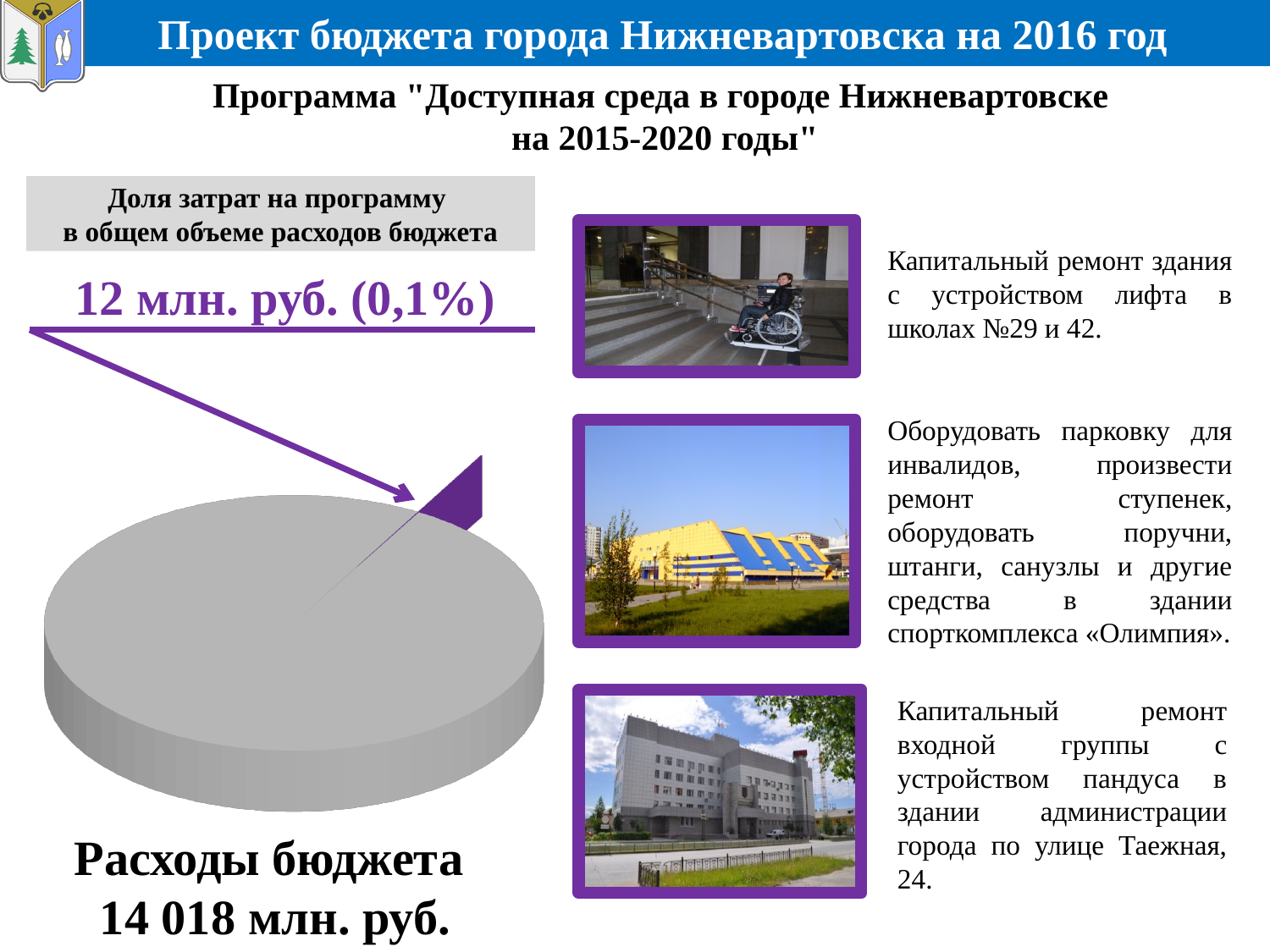
What kind of chart is shown on the slide? pie chart What share of total budget expenditure does the program slice represent in the pie chart? 0,1% Is the program expenditure share in the pie chart greater or less than 1%? less How many slices does the pie chart have? 2 What colour is the slice representing the program expenditure in the pie chart? purple Which slice of the pie chart is larger: the program expenditure slice or the rest of the budget expenditure? the rest of the budget expenditure What is the heading above the pie chart describing what it shows? Доля затрат на программу в общем объеме расходов бюджета What is the total budget expenditure shown below the pie chart? 14 018 млн. руб. What is the value of the program expenditure slice highlighted in the pie chart? 12 млн. руб.